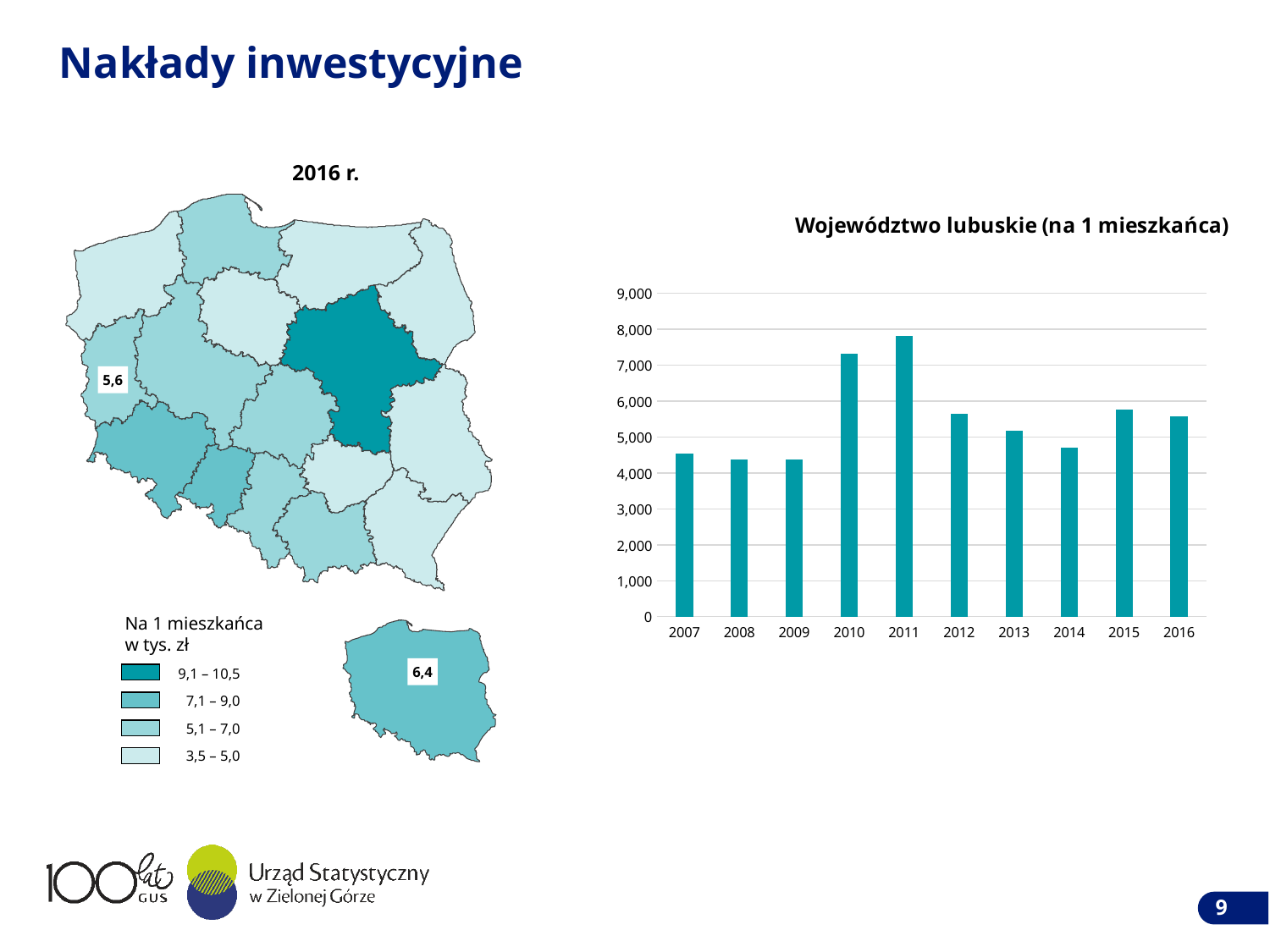
In the 'Województwo lubuskie (na 1 mieszkańca)' chart, how many years are shown on the x axis? 10 What kind of chart is the 'Województwo lubuskie (na 1 mieszkańca)' chart? bar chart In the 'Województwo lubuskie (na 1 mieszkańca)' chart, is the value for 2007 greater or less than 5,000? less In the 'Województwo lubuskie (na 1 mieszkańca)' chart, which year has the highest value? 2011 In the 'Województwo lubuskie (na 1 mieszkańca)' chart, is the value for 2015 greater or less than 5,000? greater In the 'Województwo lubuskie (na 1 mieszkańca)' chart, is the value for 2011 greater or less than 8,000? less In the 'Województwo lubuskie (na 1 mieszkańca)' chart, which is larger, the value for 2012 or the value for 2014? 2012 What is the title of the bar chart on the right side of the slide? Województwo lubuskie (na 1 mieszkańca) In the 'Województwo lubuskie (na 1 mieszkańca)' chart, which is larger, the value for 2010 or the value for 2011? 2011 In the 'Województwo lubuskie (na 1 mieszkańca)' chart, do the values rise or fall from 2011 to 2014? fall